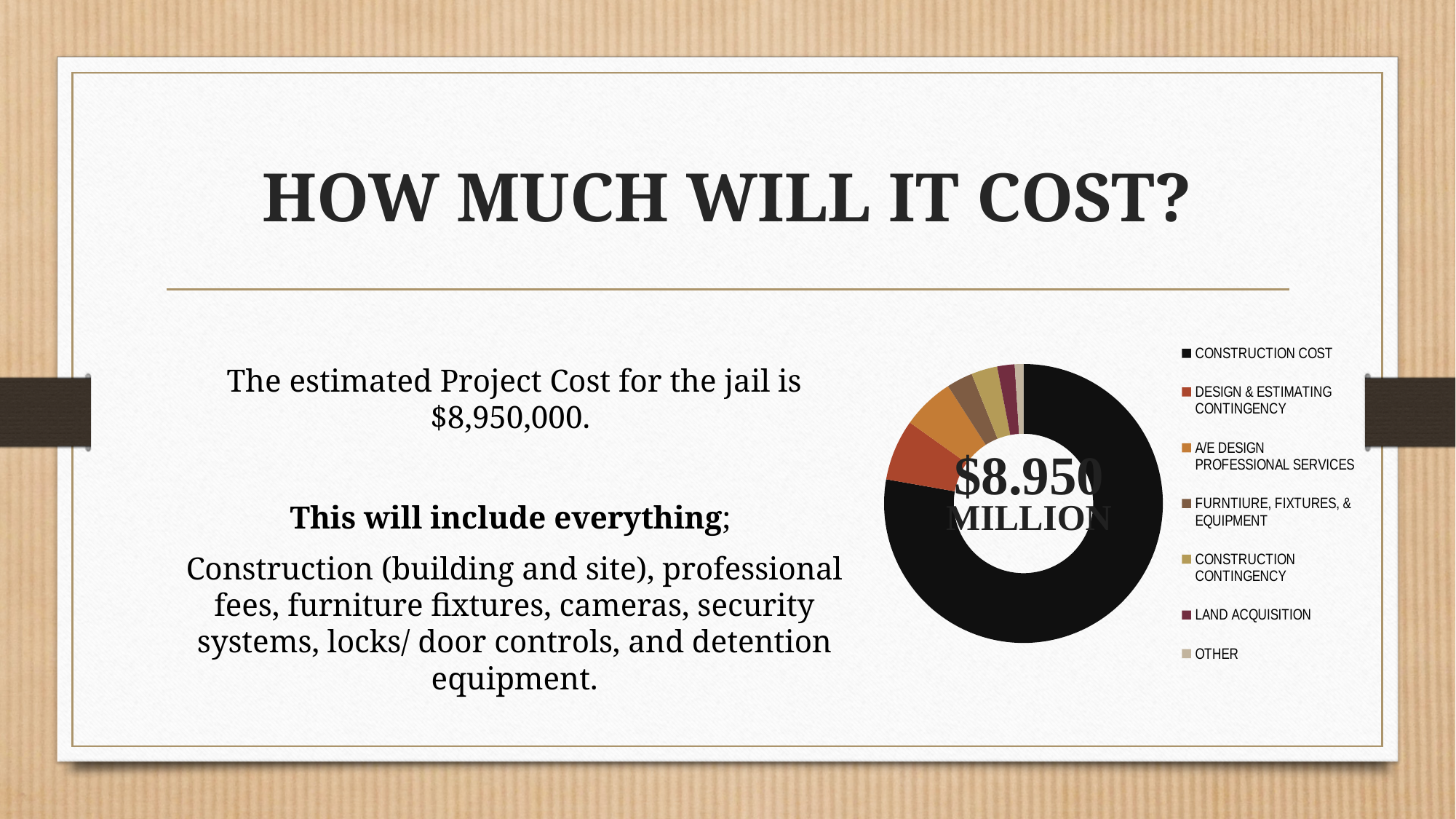
Which is larger in the pie chart: CONSTRUCTION COST or DESIGN & ESTIMATING CONTINGENCY? CONSTRUCTION COST What colour represents CONSTRUCTION COST in the chart? Black What kind of chart is shown on the slide? Pie chart (doughnut) Which is larger in the pie chart: DESIGN & ESTIMATING CONTINGENCY or LAND ACQUISITION? DESIGN & ESTIMATING CONTINGENCY Which category takes up the largest share of the pie chart? CONSTRUCTION COST How many categories does the chart's legend list? 7 Which is larger in the pie chart: A/E DESIGN PROFESSIONAL SERVICES or OTHER? A/E DESIGN PROFESSIONAL SERVICES What text is printed in the centre of the doughnut chart? $8.950 MILLION